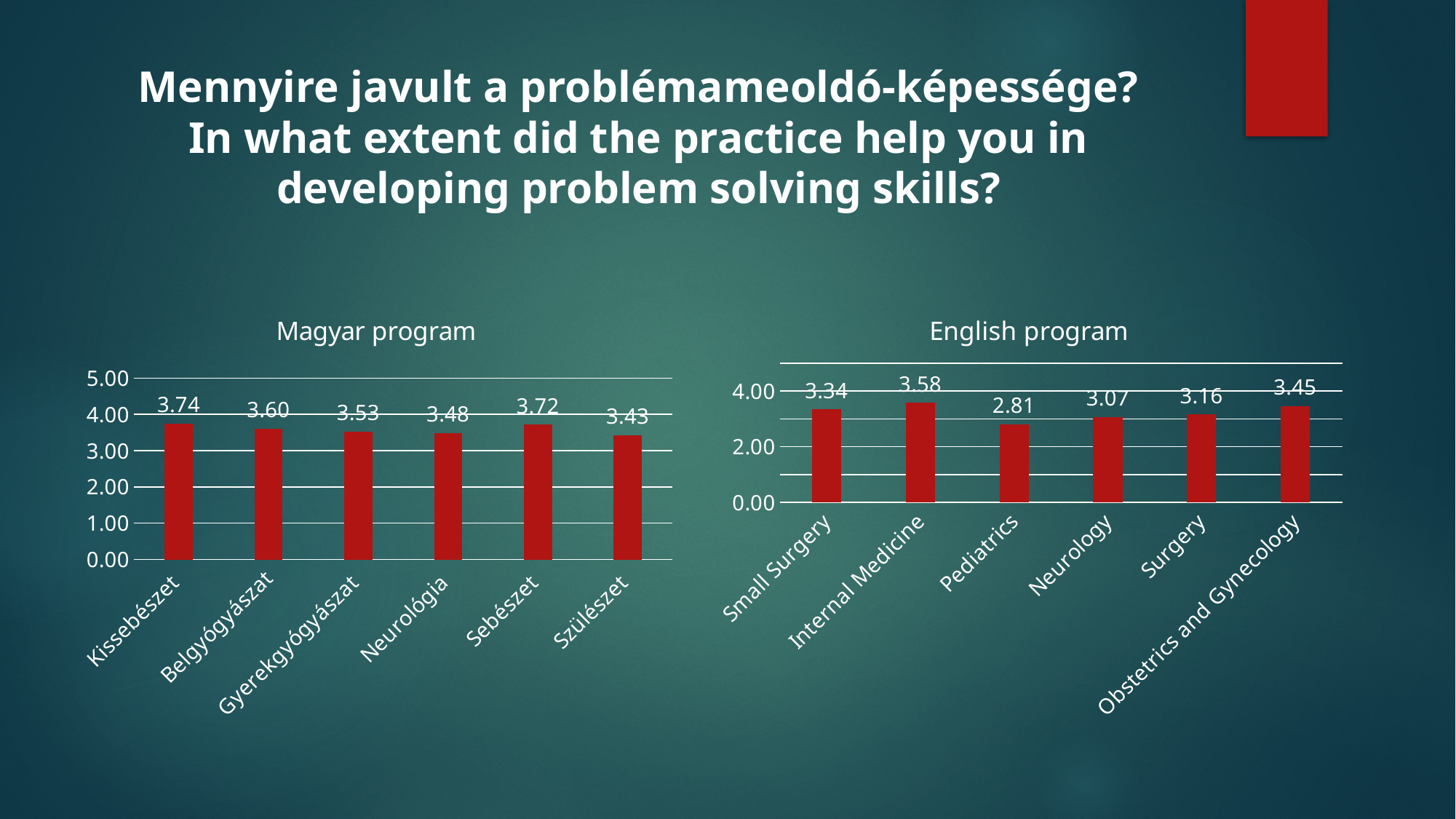
In the Magyar program chart, what is the value for Kissebészet? 3.74 In the English program chart, which category has the lowest value? Pediatrics In the English program chart, is the value for Obstetrics and Gynecology greater or less than 4.00? less In the Magyar program chart, how many categories are shown? 6 What kind of chart is the English program chart? Bar chart In the English program chart, what is the difference between Internal Medicine and Pediatrics? 0.77 In the Magyar program chart, what is the difference between Kissebészet and Szülészet? 0.31 In the English program chart, which category has the highest value? Internal Medicine In the Magyar program chart, what is the value for Neurológia? 3.48 In the English program chart, what is the value for Pediatrics? 2.81 In the English program chart, which is larger, Small Surgery or Surgery? Small Surgery In the Magyar program chart, which category has the lowest value? Szülészet